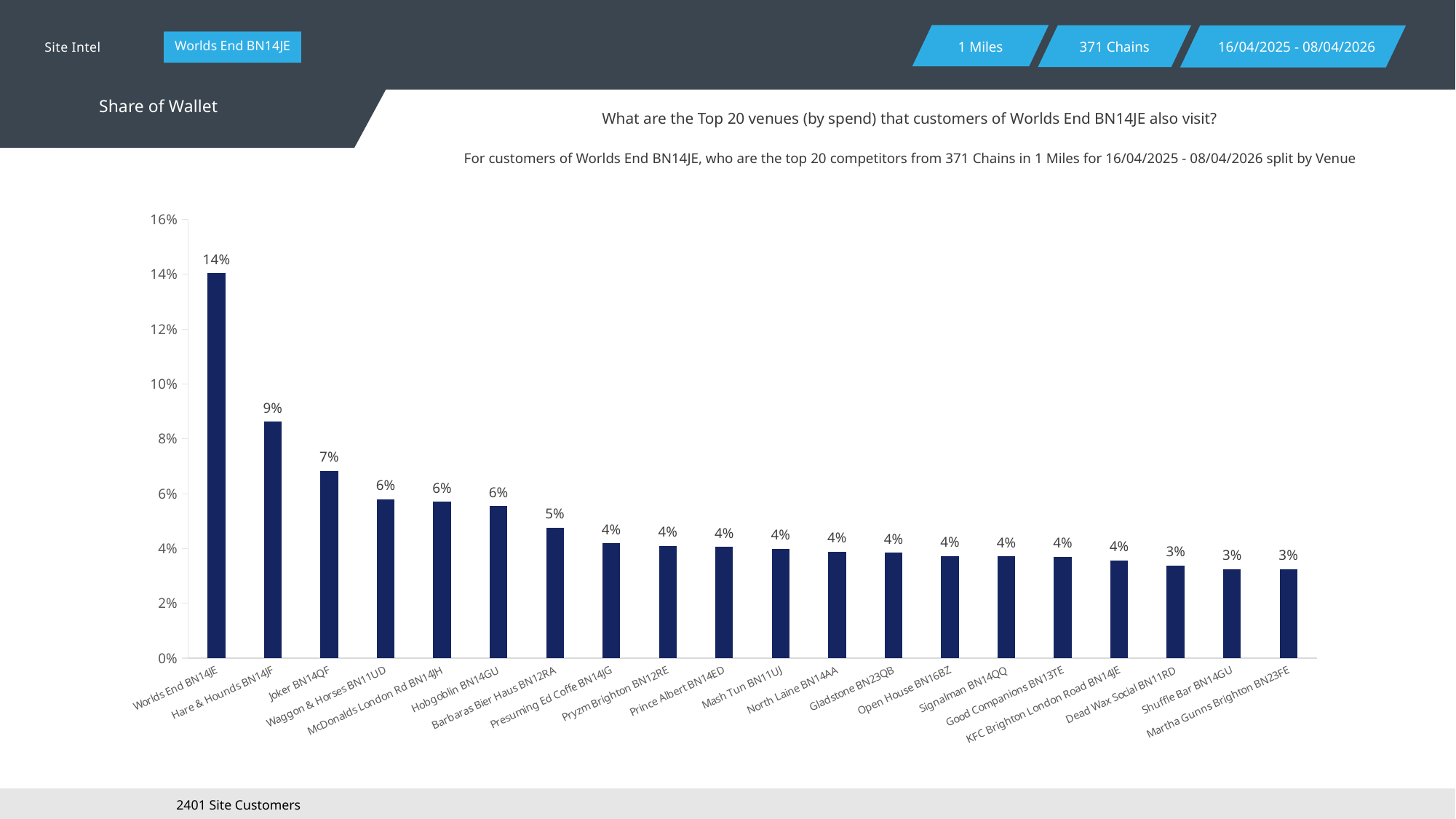
Is the value for Worlds End BN14JE greater or less than 10%? greater How many venues are shown on the chart? 20 What is the difference between the values for Worlds End BN14JE and Hare & Hounds BN14JF? 5% Which venue has the highest value? Worlds End BN14JE What is the value for Worlds End BN14JE? 14% What kind of chart is shown on the slide? bar chart Do the values rise or fall from left to right along the x axis? fall What is the value for Joker BN14QF? 7% What is the value for Dead Wax Social BN11RD? 3% What is the value for Barbaras Bier Haus BN12RA? 5% Which is larger, the value for Hare & Hounds BN14JF or the value for Joker BN14QF? Hare & Hounds BN14JF What is the value for Hare & Hounds BN14JF? 9%